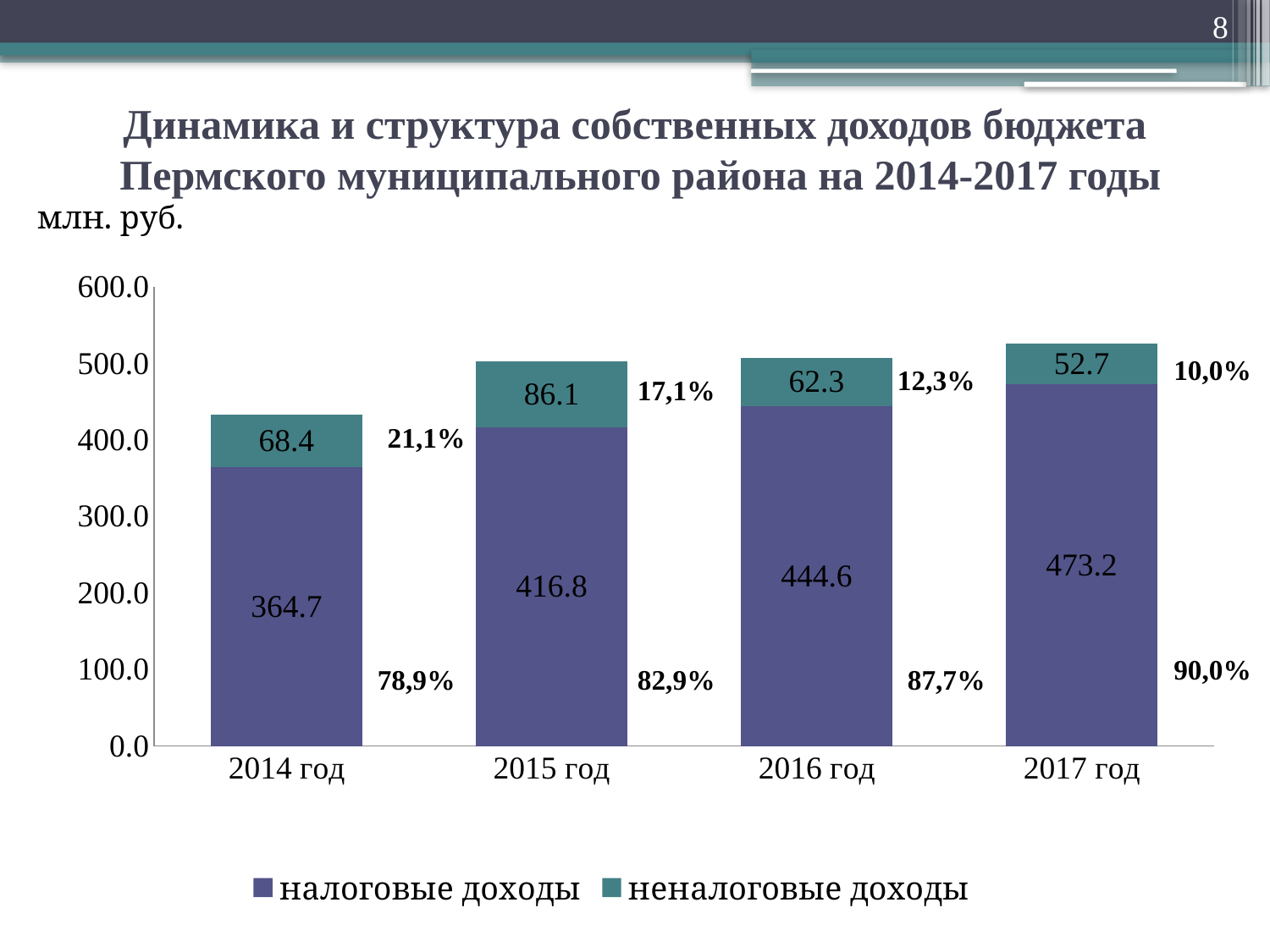
What is the value of налоговые доходы for 2014 год? 364.7 What is the value of неналоговые доходы for 2017 год? 52.7 What kind of chart is shown on the slide? Stacked bar chart What is the difference between налоговые доходы in 2017 год and 2016 год? 28.6 What is the value of налоговые доходы for 2015 год? 416.8 Which year has the lowest value of налоговые доходы? 2014 год What is the total of the stacked bar for 2014 год? 433.1 Which is larger: неналоговые доходы in 2016 год or in 2017 год? 2016 год How many series does the legend list? 2 Which year has the highest value of неналоговые доходы? 2015 год How many years are shown on the x axis? 4 Do the values of налоговые доходы rise or fall from 2014 год to 2017 год? Rise